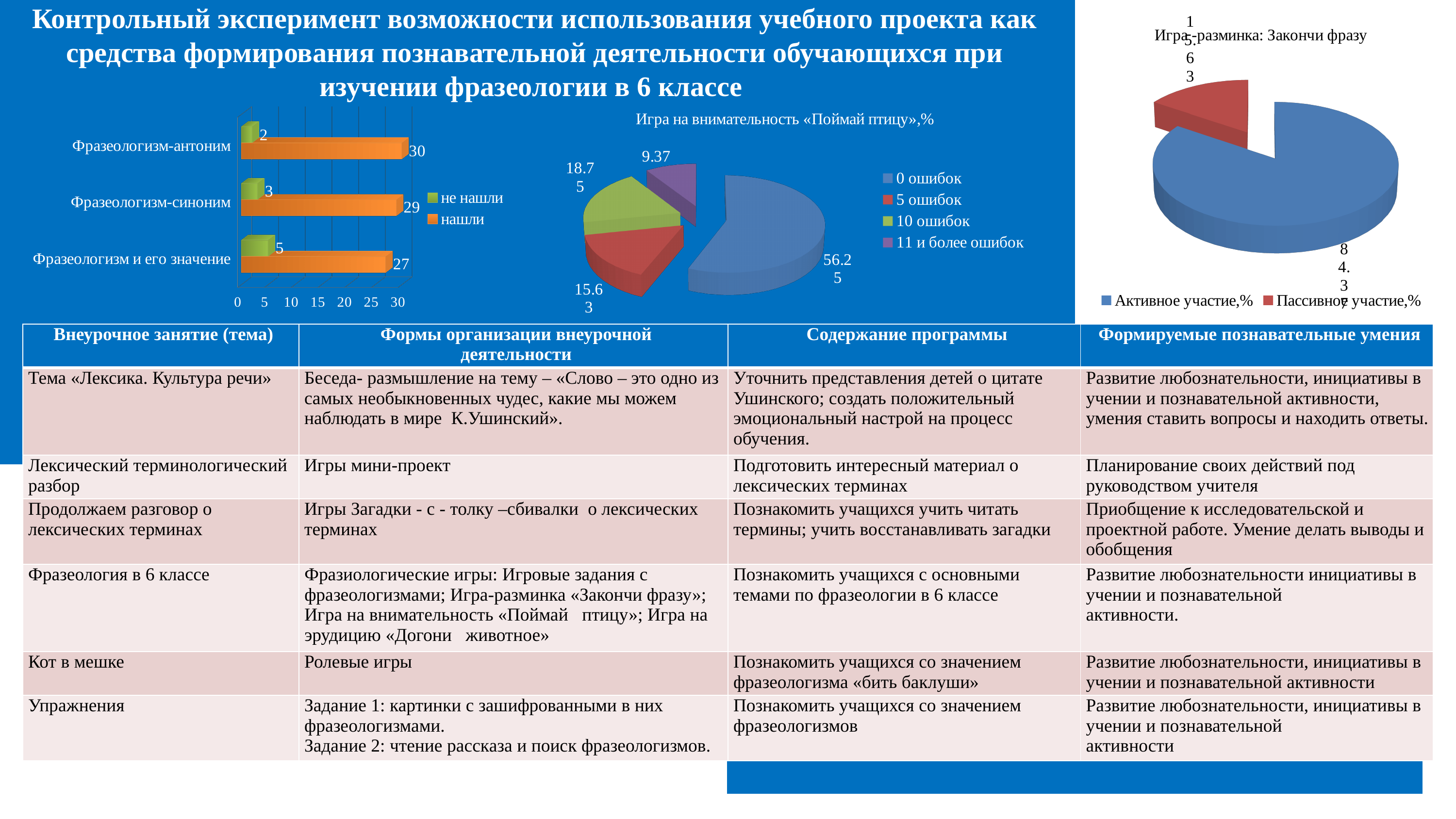
In the pie chart «Игра на внимательность «Поймай птицу»,%», which category has the largest slice? 0 ошибок How many categories does the legend of the pie chart «Игра на внимательность «Поймай птицу»,%» list? 4 In the pie chart «Игра-разминка: Закончи фразу», which category has the larger slice? Активное участие,% In the left bar chart, what is the value of «не нашли» for «Фразеологизм и его значение»? 5 In the left bar chart, what is the value of «нашли» for «Фразеологизм-синоним»? 29 In the left bar chart, which category has the highest «нашли» value? Фразеологизм-антоним In the left bar chart, which category has the lowest «не нашли» value? Фразеологизм-антоним What kind of chart is the left chart on the slide? bar chart In the left bar chart, what is the difference between the «нашли» and «не нашли» values for «Фразеологизм и его значение»? 22 In the pie chart «Игра на внимательность «Поймай птицу»,%», what is the value for «11 и более ошибок»? 9.37 In the left bar chart, what is the value of «нашли» for «Фразеологизм-антоним»? 30 How many series does the legend of the left bar chart list? 2